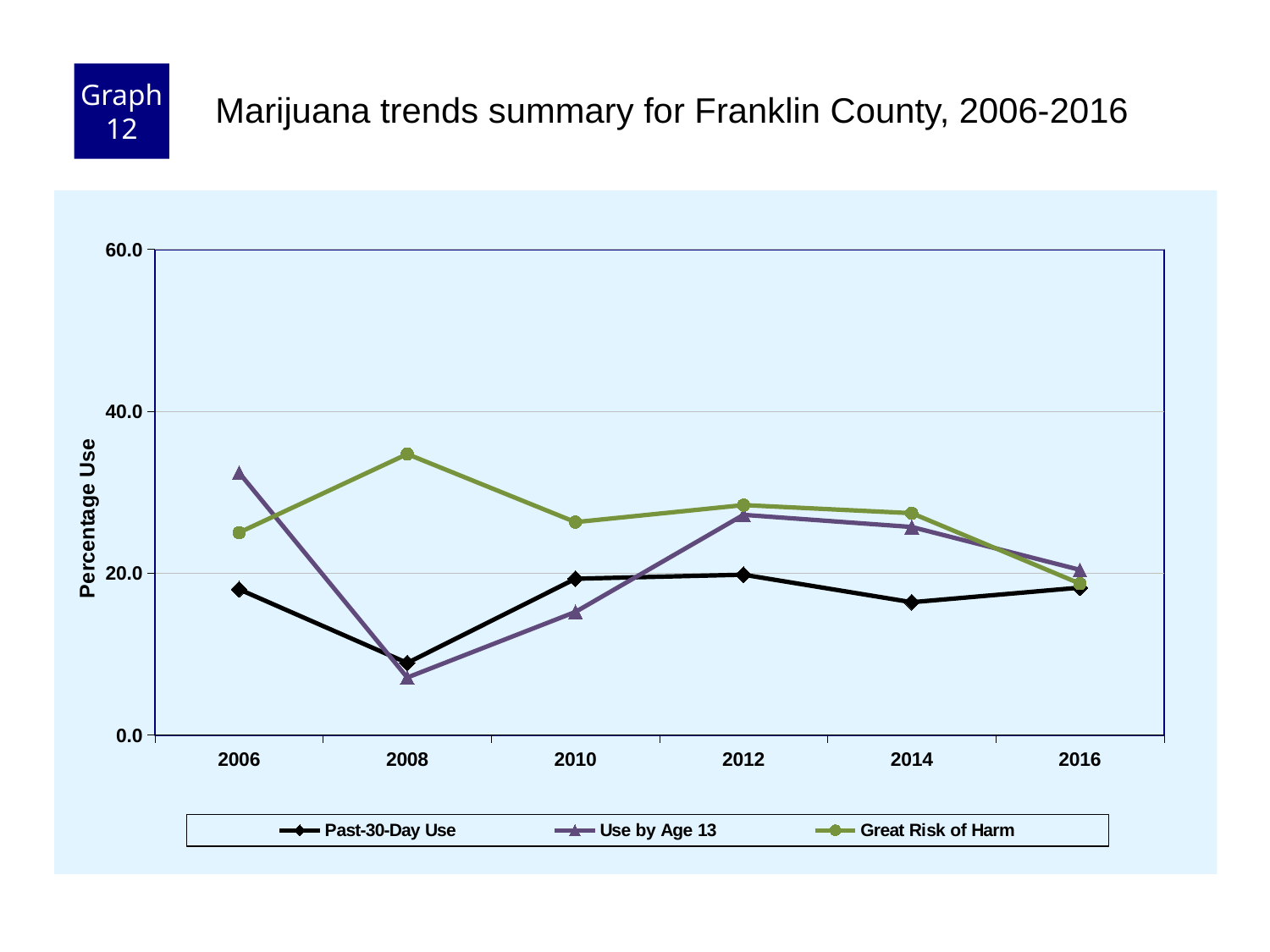
What is the label of the vertical axis? Percentage Use In which year does the Great Risk of Harm series reach its highest value? 2008 Is the value for Past-30-Day Use in 2008 greater or less than 20.0? less Does the Past-30-Day Use series rise or fall from 2006 to 2008? fall Which series is drawn with triangle markers? Use by Age 13 How many years are plotted along the x axis? 6 What kind of chart is shown on the slide? line chart In 2006, which is larger: Use by Age 13 or Past-30-Day Use? Use by Age 13 Is the value for Great Risk of Harm in 2008 greater or less than 40.0? less In which year does the Use by Age 13 series reach its lowest value? 2008 How many series does the legend list? 3 Is the value for Use by Age 13 in 2006 greater or less than 20.0? greater